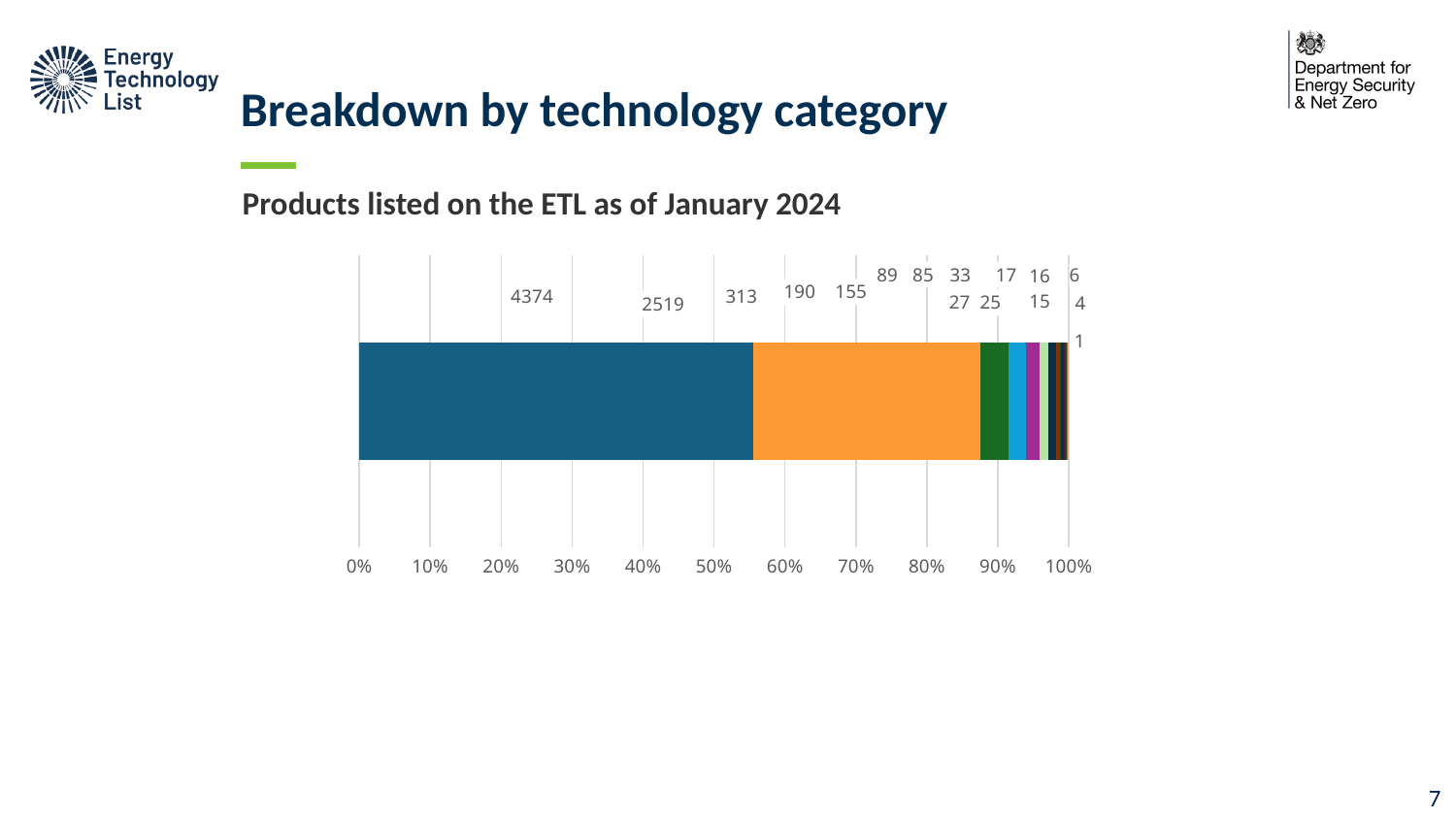
What is the smallest value labelled on the stacked bar? 1 What is the value labelled for the orange segment of the bar? 2519 What is the title shown above the chart? Products listed on the ETL as of January 2024 Which is larger, the segment labelled 313 or the segment labelled 190? 313 Does the dark blue segment (4374) extend to greater or less than 50% of the bar? greater What is the total of all the labelled values in the stacked bar? 7869 What kind of chart is shown on the slide? Stacked bar chart What is the largest value labelled on the stacked bar? 4374 What is the difference between the two largest labelled values, 4374 and 2519? 1855 How many segments (data labels) make up the stacked bar? 16 What is the second largest value labelled on the stacked bar? 2519 What colour is the largest segment of the bar? Dark blue